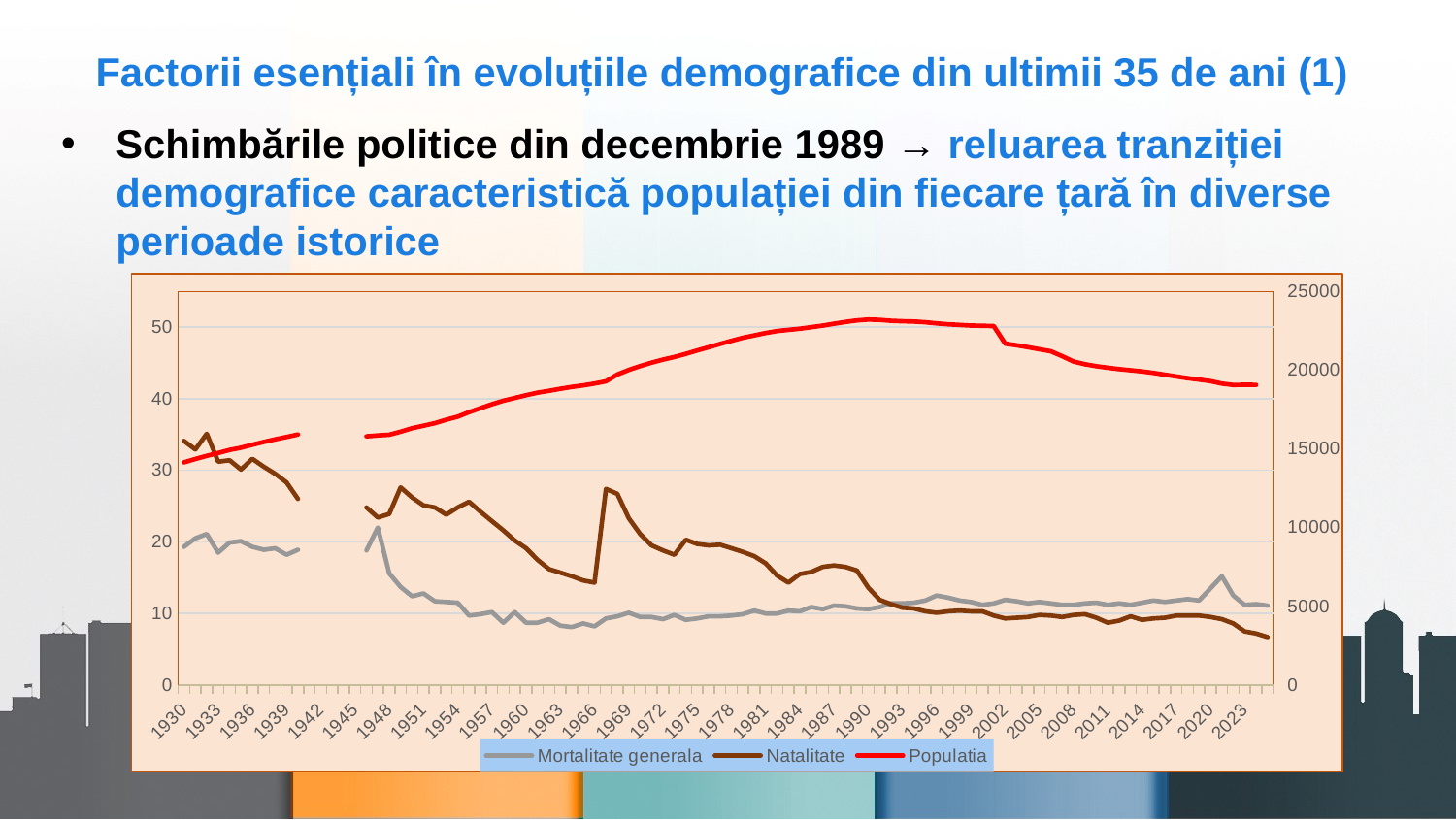
What kind of chart is shown on the slide? line chart Is the value for Natalitate in 1968 greater or less than 20? greater Is the value for Populatia in 1990 greater or less than 20000? greater In 2023, which is higher: Mortalitate generala or Natalitate? Mortalitate generala Which series is plotted against the right-hand axis that goes up to 25000? Populatia What are the three series named in the chart legend? Mortalitate generala, Natalitate, Populatia Is the value for Natalitate in 2023 greater or less than 10? less How many series does the chart legend list? 3 In 1930, which is higher: Natalitate or Mortalitate generala? Natalitate Does the Populatia line rise or fall between 1990 and 2023? fall